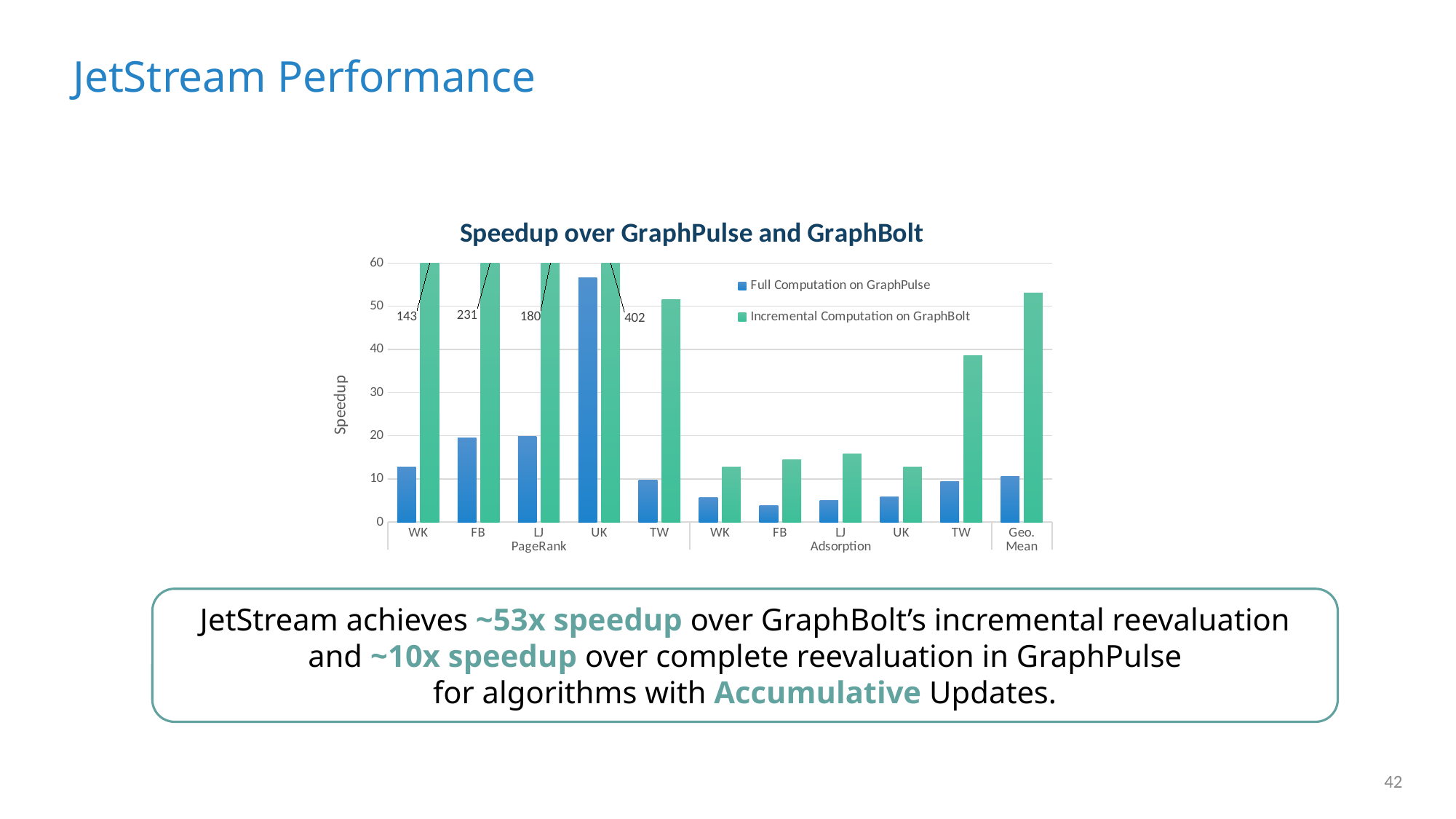
Which category has the highest Incremental Computation on GraphBolt speedup? UK (PageRank) What is the difference between the Incremental Computation on GraphBolt speedups for UK and WK under PageRank? 259 How many categories are shown along the x axis of the chart? 11 Is the Full Computation on GraphPulse speedup for UK under PageRank greater or less than 50? greater What is the Incremental Computation on GraphBolt speedup for FB under PageRank? 231 What is the label on the y axis of the chart? Speedup Which is larger: the Incremental Computation on GraphBolt speedup for TW under Adsorption or for LJ under Adsorption? TW under Adsorption What is the Incremental Computation on GraphBolt speedup for WK under PageRank? 143 What is the Incremental Computation on GraphBolt speedup for UK under PageRank? 402 How many series does the legend list in the 'Speedup over GraphPulse and GraphBolt' chart? 2 Which category has the lowest Full Computation on GraphPulse speedup? FB (Adsorption) What kind of chart is shown on the slide? Bar chart